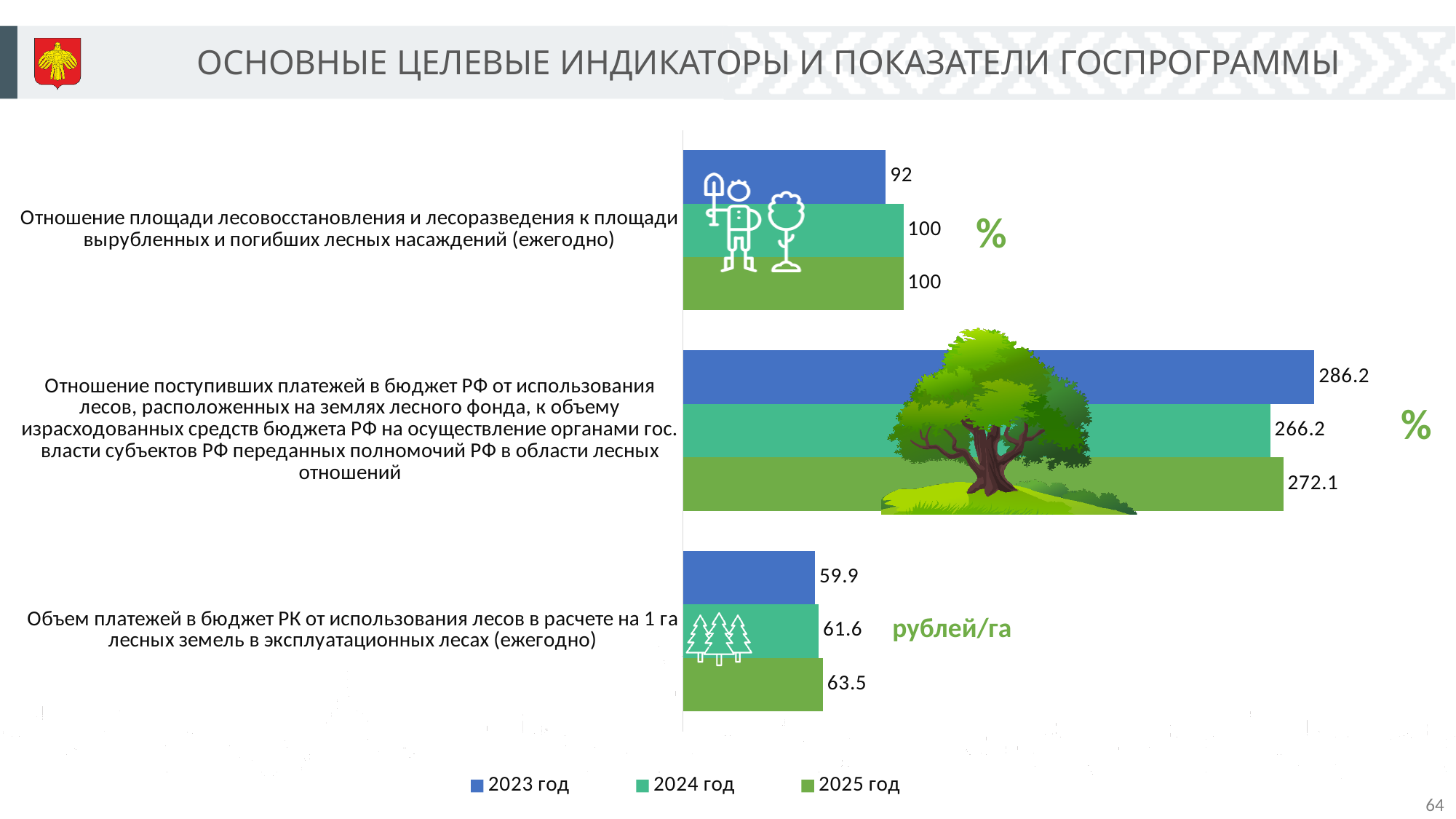
What unit is shown next to the bars for the indicator 'Объем платежей в бюджет РК...'? рублей/га Do the values for the indicator 'Объем платежей в бюджет РК...' rise or fall from 2023 to 2025? rise What type of chart is shown on the slide? bar chart What is the 2023 value for the indicator 'Отношение площади лесовосстановления и лесоразведения к площади вырубленных и погибших лесных насаждений'? 92 What is the 2025 value for the indicator 'Объем платежей в бюджет РК от использования лесов в расчете на 1 га лесных земель'? 63.5 What is the difference between the 2023 and 2024 values for the indicator 'Отношение поступивших платежей в бюджет РФ...'? 20 How many series does the legend list? 3 For the indicator 'Объем платежей в бюджет РК...', which is larger: the 2024 value or the 2025 value? 2025 год What is the 2024 value for the indicator 'Отношение поступивших платежей в бюджет РФ от использования лесов...'? 266.2 For the indicator 'Объем платежей в бюджет РК...', which year has the lowest value? 2023 год How many indicator categories are plotted on the chart? 3 For the indicator 'Отношение поступивших платежей в бюджет РФ...', which year has the highest value? 2023 год